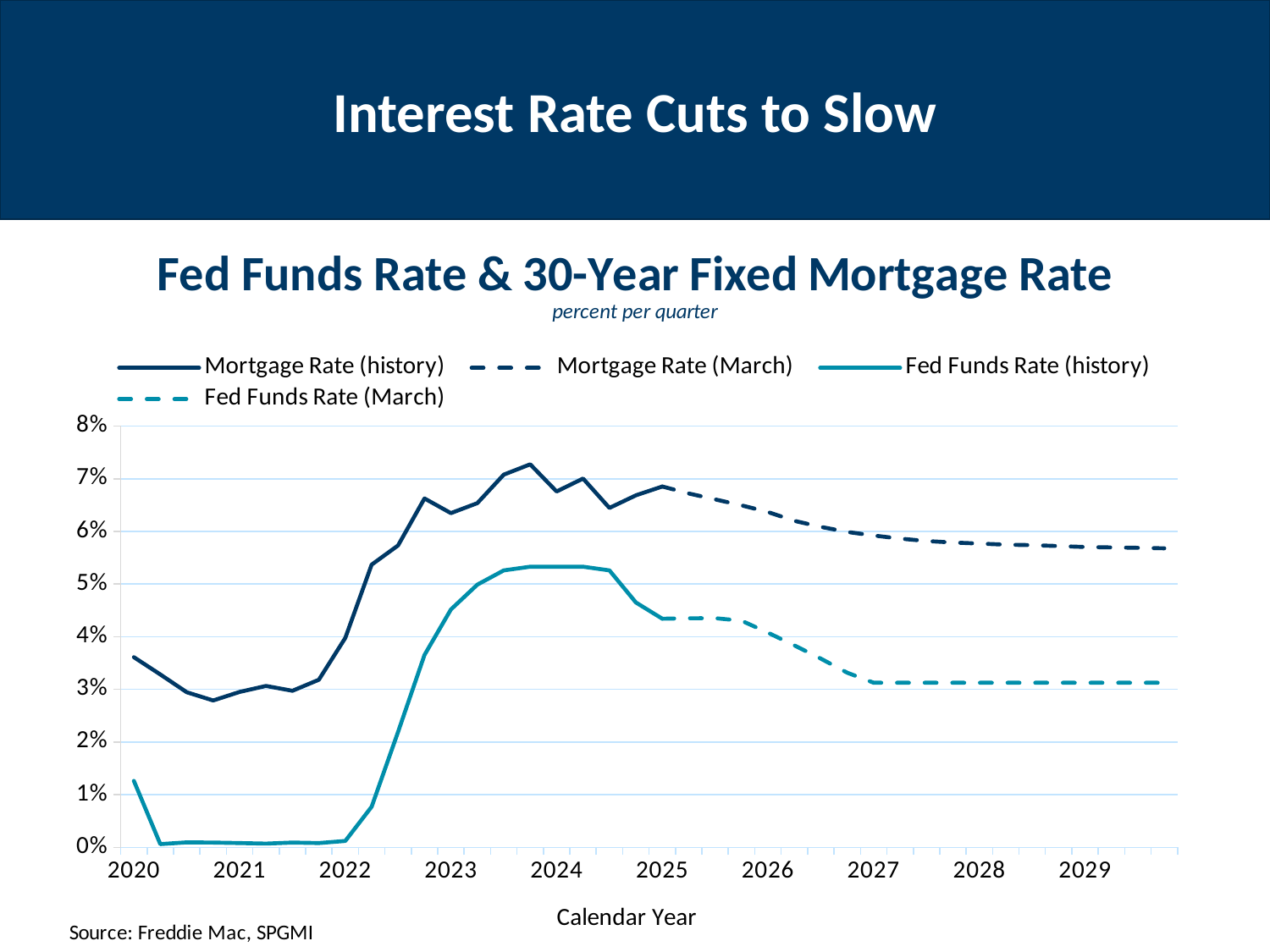
What kind of chart is shown on the slide? line chart Is the peak value of Mortgage Rate (history) in late 2023 greater or less than 7%? greater Does the Mortgage Rate (March) series rise or fall from 2025 to 2029? fall Is the value for Fed Funds Rate (history) at the start of 2021 greater or less than 1%? less What is the title of the chart? Fed Funds Rate & 30-Year Fixed Mortgage Rate What is the label of the x axis? Calendar Year How many series does the legend list? 4 Is the value for Fed Funds Rate (history) at the start of 2024 greater or less than 5%? greater At the start of 2024, which is higher: Mortgage Rate (history) or Fed Funds Rate (history)? Mortgage Rate (history)